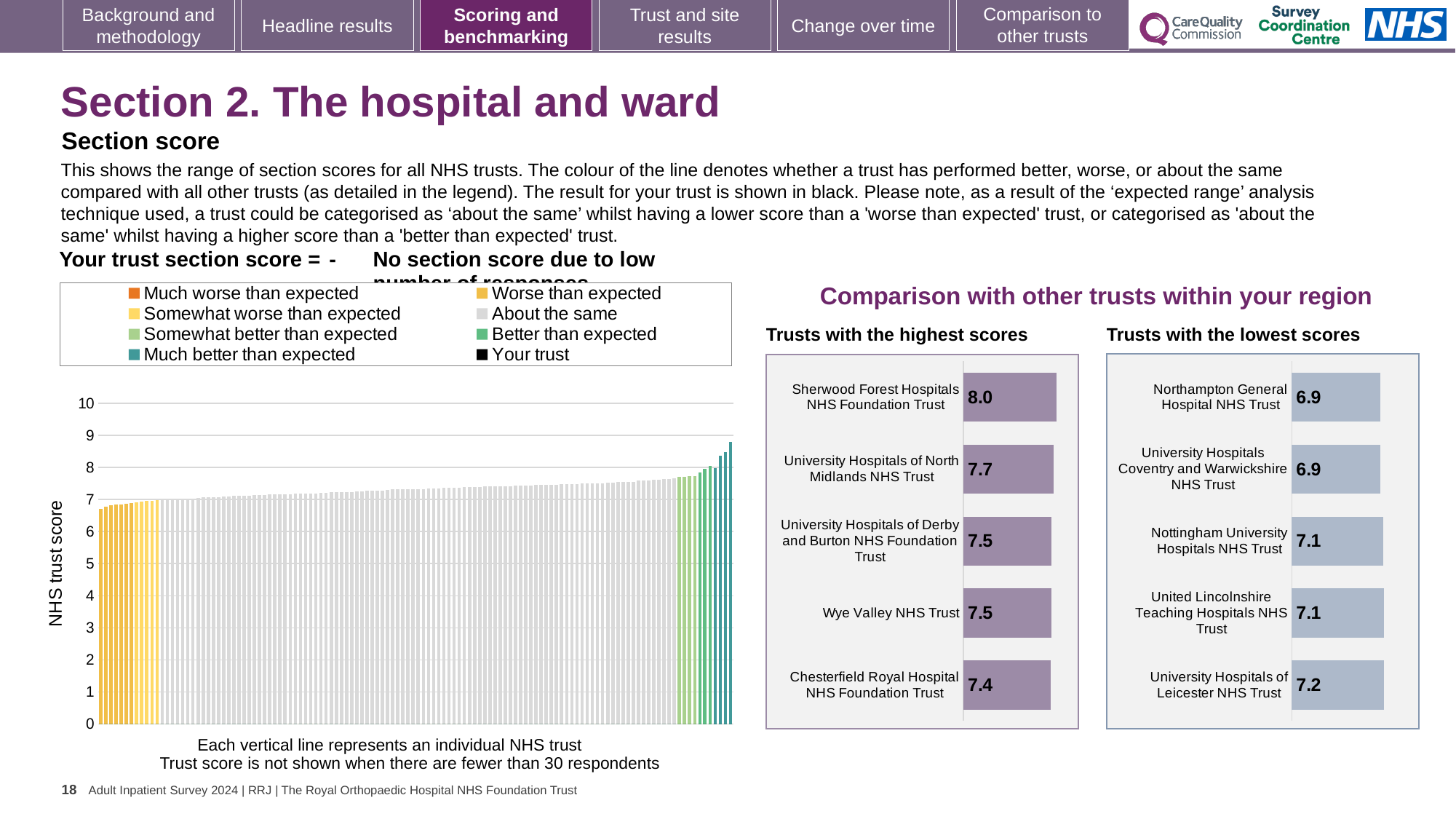
In the 'Trusts with the highest scores' chart, which trust has the highest score? Sherwood Forest Hospitals NHS Foundation Trust In the 'Trusts with the lowest scores' chart, how many trusts are shown? 5 In the 'Trusts with the lowest scores' chart, what is the score for Nottingham University Hospitals NHS Trust? 7.1 In the 'Trusts with the highest scores' chart, what is the score for Sherwood Forest Hospitals NHS Foundation Trust? 8.0 In the 'Trusts with the lowest scores' chart, what is the difference between the scores of University Hospitals of Leicester NHS Trust and Northampton General Hospital NHS Trust? 0.3 Which has the larger score: Wye Valley NHS Trust in the 'Trusts with the highest scores' chart or University Hospitals of Leicester NHS Trust in the 'Trusts with the lowest scores' chart? Wye Valley NHS Trust In the 'Trusts with the highest scores' chart, which trust has the lowest score? Chesterfield Royal Hospital NHS Foundation Trust In the large 'NHS trust score' chart on the left, is the tallest bar greater or less than 8? greater What kind of chart is the large 'NHS trust score' chart on the left of the slide? Bar chart In the 'Trusts with the lowest scores' chart, which trust has the highest score? University Hospitals of Leicester NHS Trust In the 'Trusts with the highest scores' chart, what is the difference between the scores of Sherwood Forest Hospitals NHS Foundation Trust and Chesterfield Royal Hospital NHS Foundation Trust? 0.6 In the 'Trusts with the highest scores' chart, what is the score for Chesterfield Royal Hospital NHS Foundation Trust? 7.4